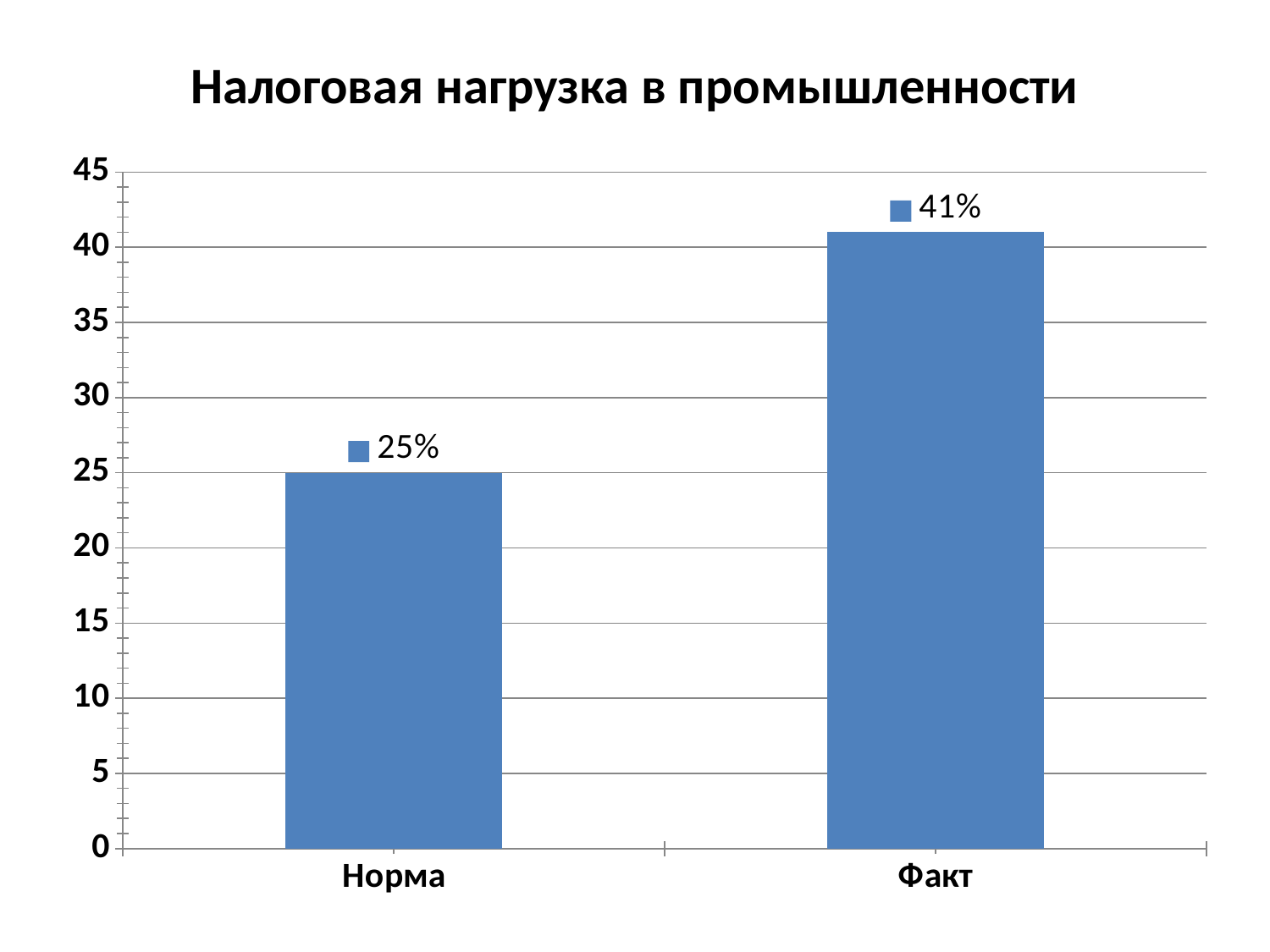
What kind of chart is shown on the slide? bar chart How many categories are shown on the x axis? 2 What is the difference between the values for Факт and Норма? 16% Which is larger, the value for Норма or the value for Факт? Факт Is the value for Факт greater or less than 40? greater What is the highest value shown on the vertical axis? 45 Which category has the lowest value? Норма Is the value for Норма greater or less than 30? less What is the value for Факт? 41% Which category has the highest value? Факт What is the value for Норма? 25% What is the title of the chart? Налоговая нагрузка в промышленности